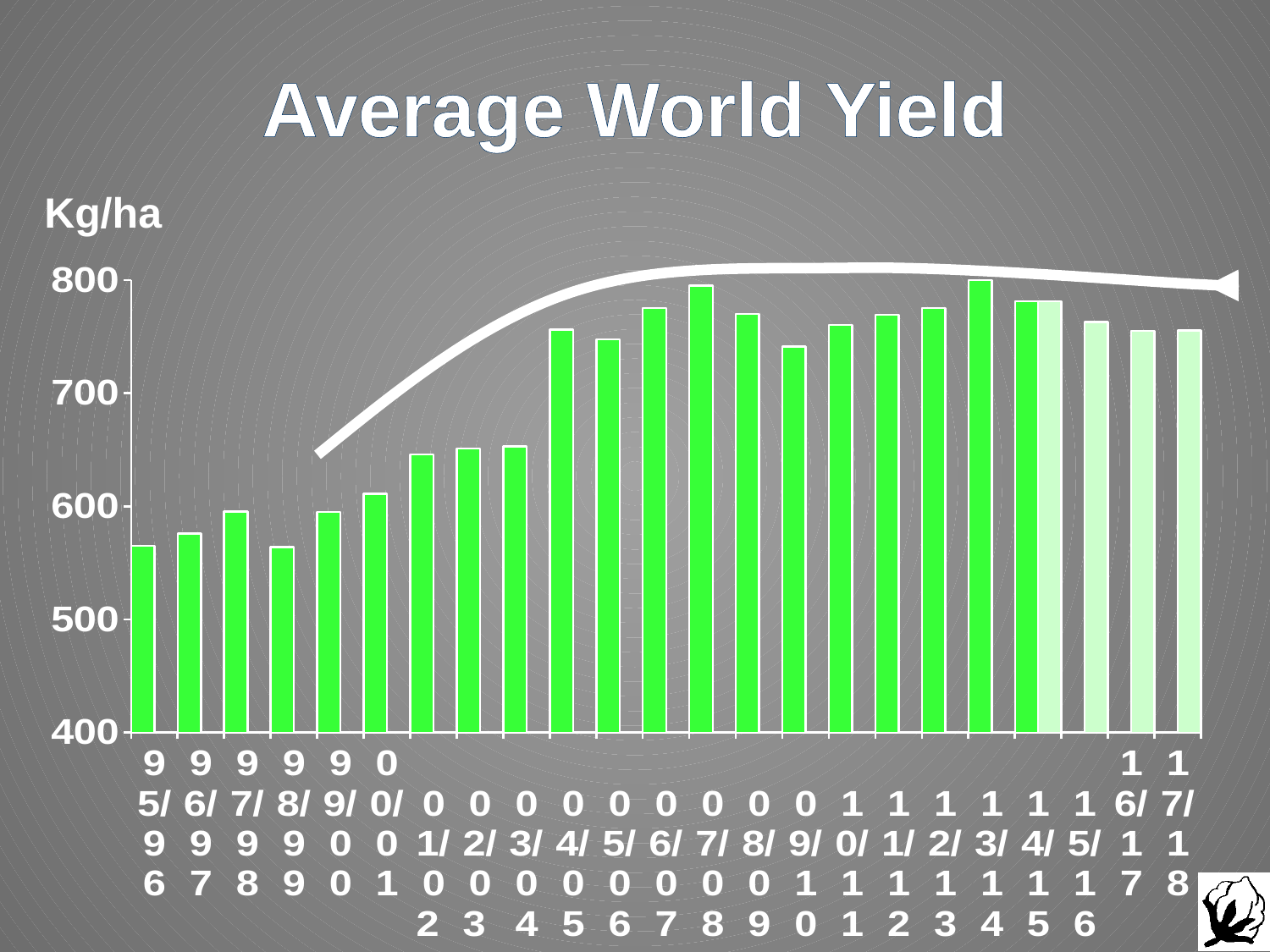
Is the value for 13/14 greater or less than 700? greater Is the value for 04/05 greater or less than 700? greater Which has the larger value, 98/99 or 00/01? 00/01 Overall, do the values rise or fall from 95/96 to 17/18? rise Is the value for 95/96 greater or less than 600? less What unit is shown for the y axis of the chart? Kg/ha What is the title of the chart? Average World Yield What kind of chart is shown on the slide? bar chart How many bars (seasons) are plotted in the chart? 23 Which has the larger value, 03/04 or 04/05? 04/05